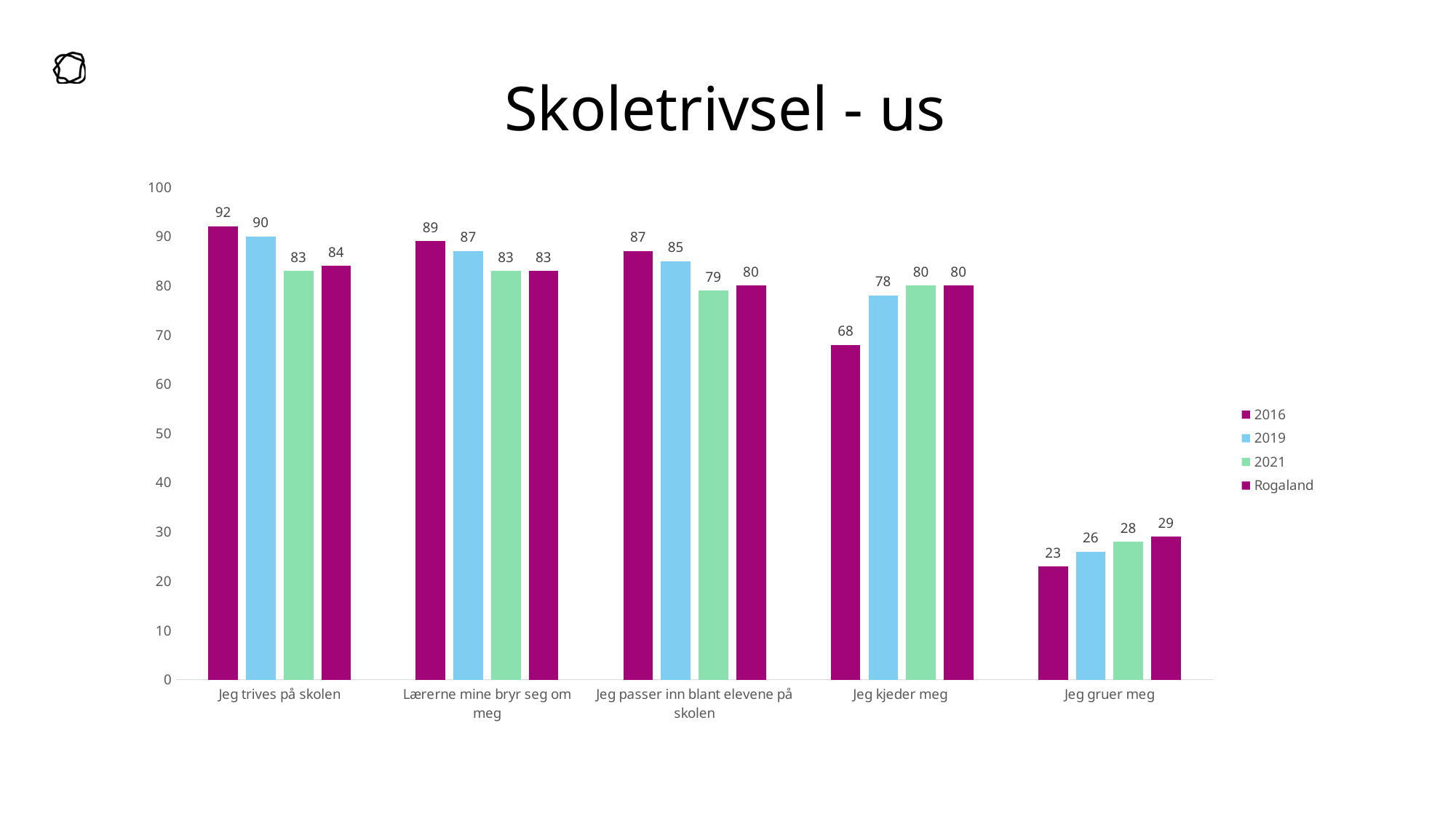
What kind of chart is shown on the slide? Bar chart Which is larger in the category "Lærerne mine bryr seg om meg": the 2016 value or the 2019 value? 2016 What is the difference between the 2016 and 2021 values in the category "Jeg kjeder meg"? 12 What is the title of the chart? Skoletrivsel - us Which category has the highest value for the 2019 series? Jeg trives på skolen What is the value for 2019 in the category "Jeg passer inn blant elevene på skolen"? 85 What is the value for 2016 in the category "Jeg trives på skolen"? 92 What is the value for 2021 in the category "Jeg kjeder meg"? 80 How many series does the legend list? 4 How many categories are shown on the x axis? 5 What is the value for Rogaland in the category "Jeg gruer meg"? 29 Which category has the lowest value for the 2016 series? Jeg gruer meg